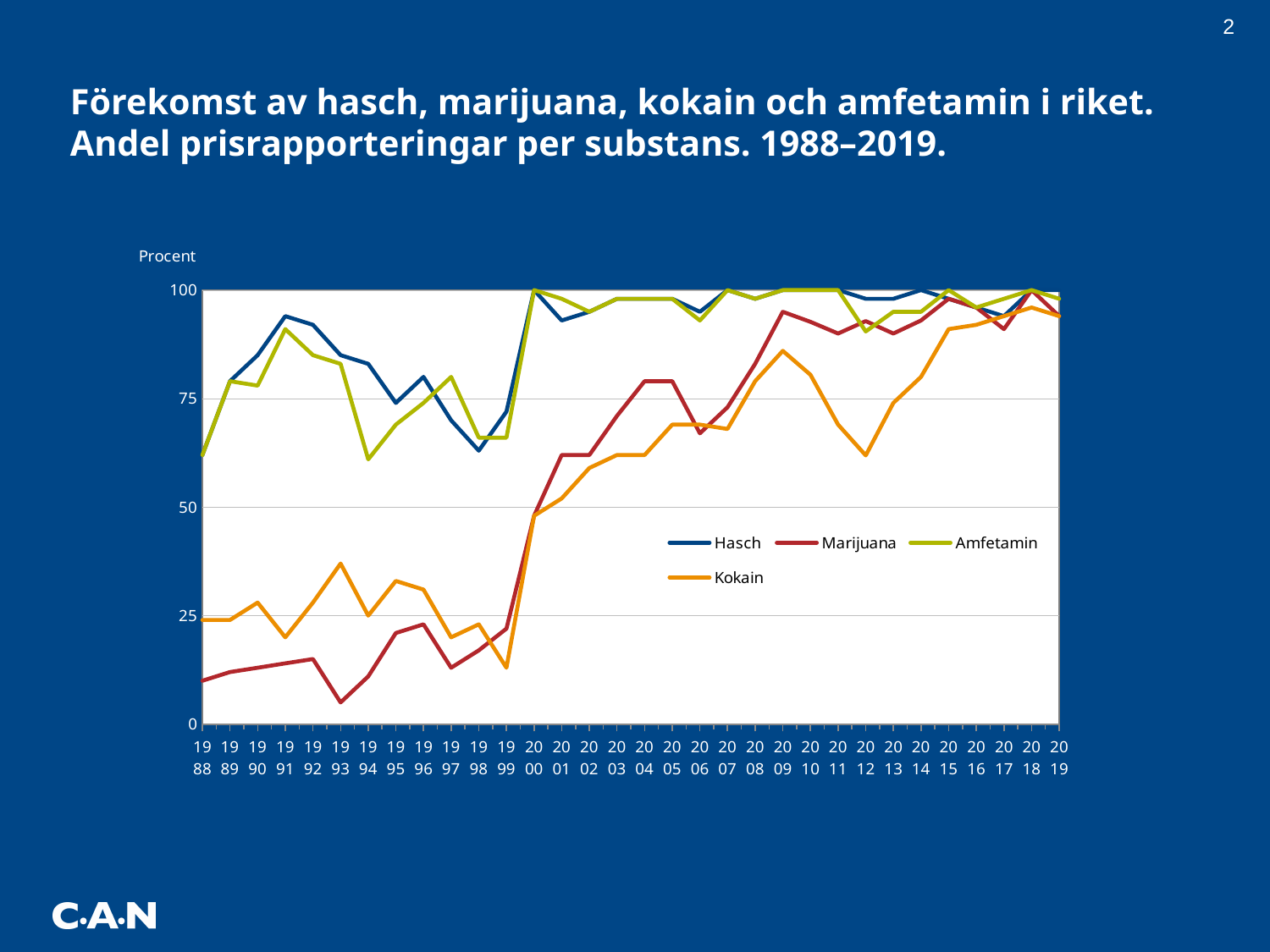
In 1993, which is larger, the value for Kokain or the value for Marijuana? Kokain Is the value for Marijuana in 1993 greater or less than 25? less Is the value for Amfetamin in 1994 greater or less than 75? less Is the value for Hasch in 1991 greater or less than 75? greater What kind of chart is shown on the slide? line chart In 2012, which is larger, the value for Amfetamin or the value for Kokain? Amfetamin How many years are plotted along the x axis? 32 Does the Kokain line rise or fall between 1999 and 2009? rise What label is shown on the vertical axis? Procent How many series does the legend list? 4 Which series has the lowest value in 1993? Marijuana